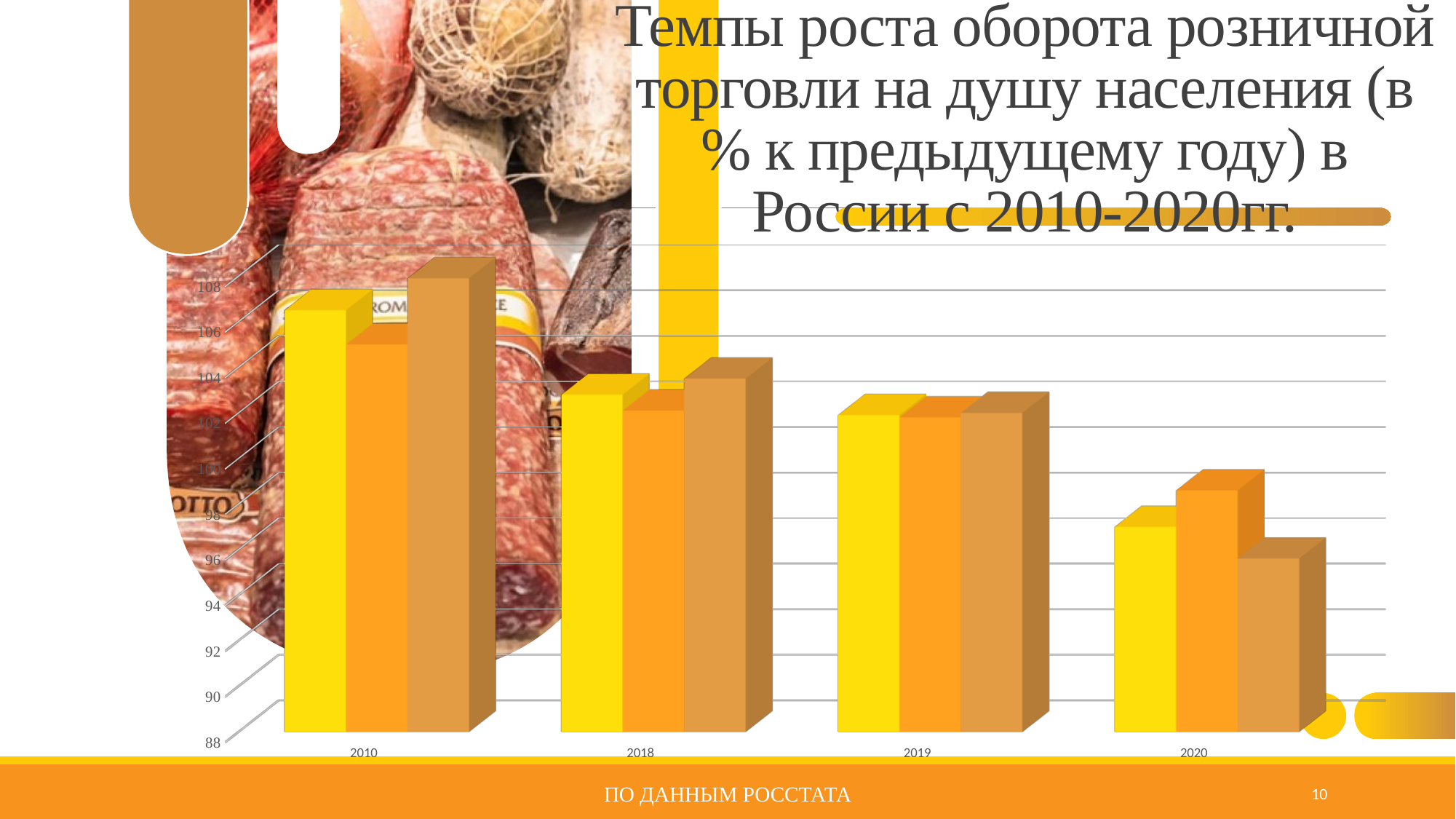
How many bars are plotted for each year in the chart? 3 Is the value of the brown (rightmost) bar for 2020 greater or less than 98? less What kind of chart is shown on the slide? bar chart What is the title of the chart on the slide? Темпы роста оборота розничной торговли на душу населения (в % к предыдущему году) в России с 2010-2020гг. Do the values in the chart generally rise or fall from 2010 to 2020? fall Is the value of the orange bar for 2020 greater or less than 102? less Which is larger: the yellow bar for 2010 or the yellow bar for 2020? the yellow bar for 2010 How many years (categories) are shown on the x axis of the chart? 4 Is the value of the yellow bar for 2010 greater or less than 106? greater Which year has the highest bars in the chart? 2010 Which year has the lowest bars in the chart? 2020